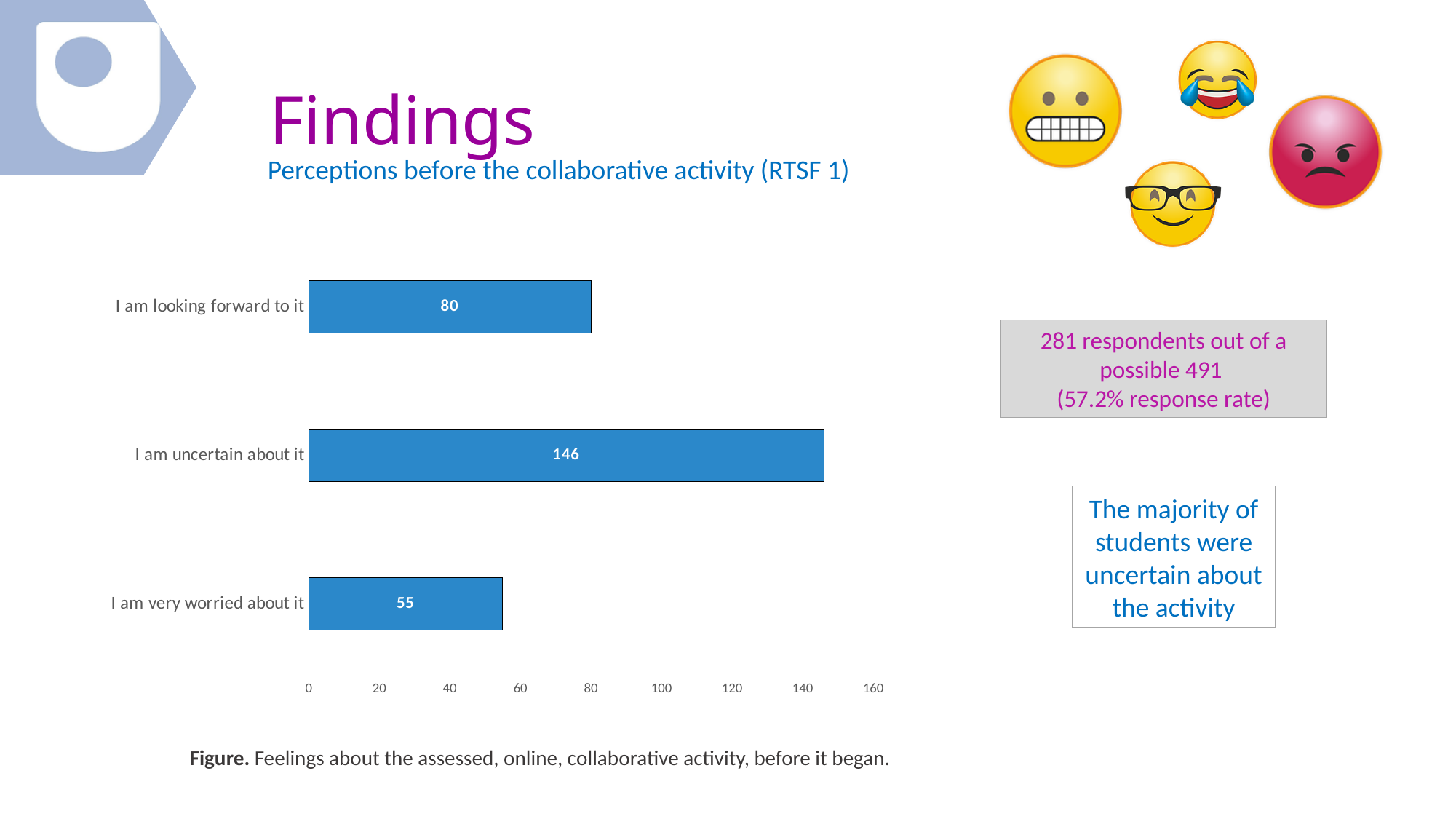
Which is larger: the value for "I am looking forward to it" or "I am very worried about it"? I am looking forward to it What is the value for "I am very worried about it"? 55 What kind of chart is shown on the slide? bar chart Which category has the highest value? I am uncertain about it What is the value for "I am looking forward to it"? 80 Which category has the lowest value? I am very worried about it How many categories are shown in the chart? 3 What is the maximum value shown on the horizontal axis? 160 What is the difference between the values for "I am looking forward to it" and "I am very worried about it"? 25 What is the value for "I am uncertain about it"? 146 What is the difference between the values for "I am uncertain about it" and "I am looking forward to it"? 66 Is the value for "I am uncertain about it" greater or less than 140? greater